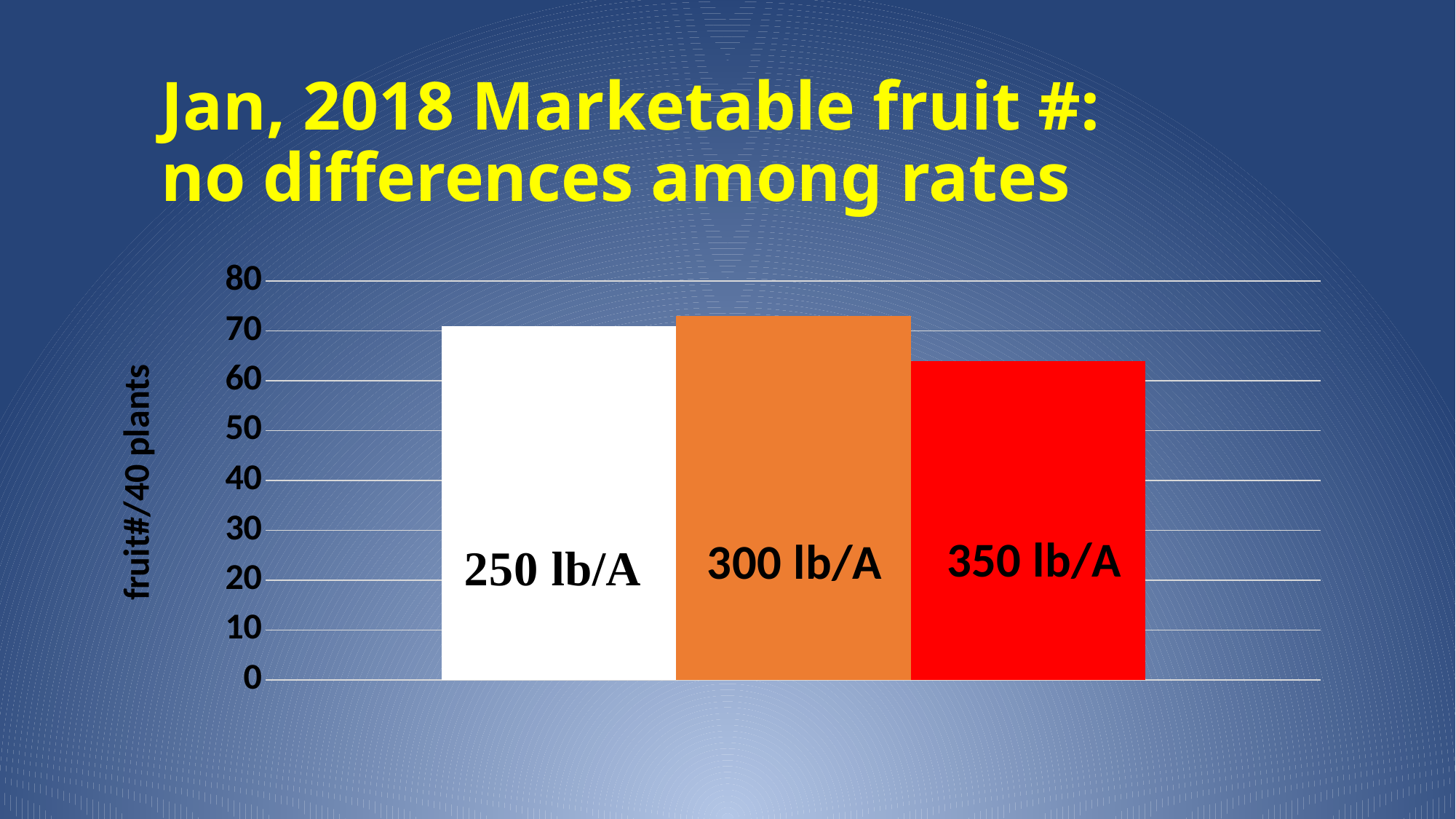
Is the value for 250 lb/A greater or less than 60? greater Is the value for 300 lb/A greater or less than 70? greater How many bars (rates) are plotted in the chart? 3 Is the value for 350 lb/A greater or less than 70? less Which rate has the lowest marketable fruit number? 350 lb/A What colour is the bar for 300 lb/A? orange Which has a higher value, 300 lb/A or 350 lb/A? 300 lb/A Which rate has the highest marketable fruit number? 300 lb/A Which has a higher value, 250 lb/A or 350 lb/A? 250 lb/A What kind of chart is shown on the slide? bar chart What is the label of the vertical axis? fruit#/40 plants